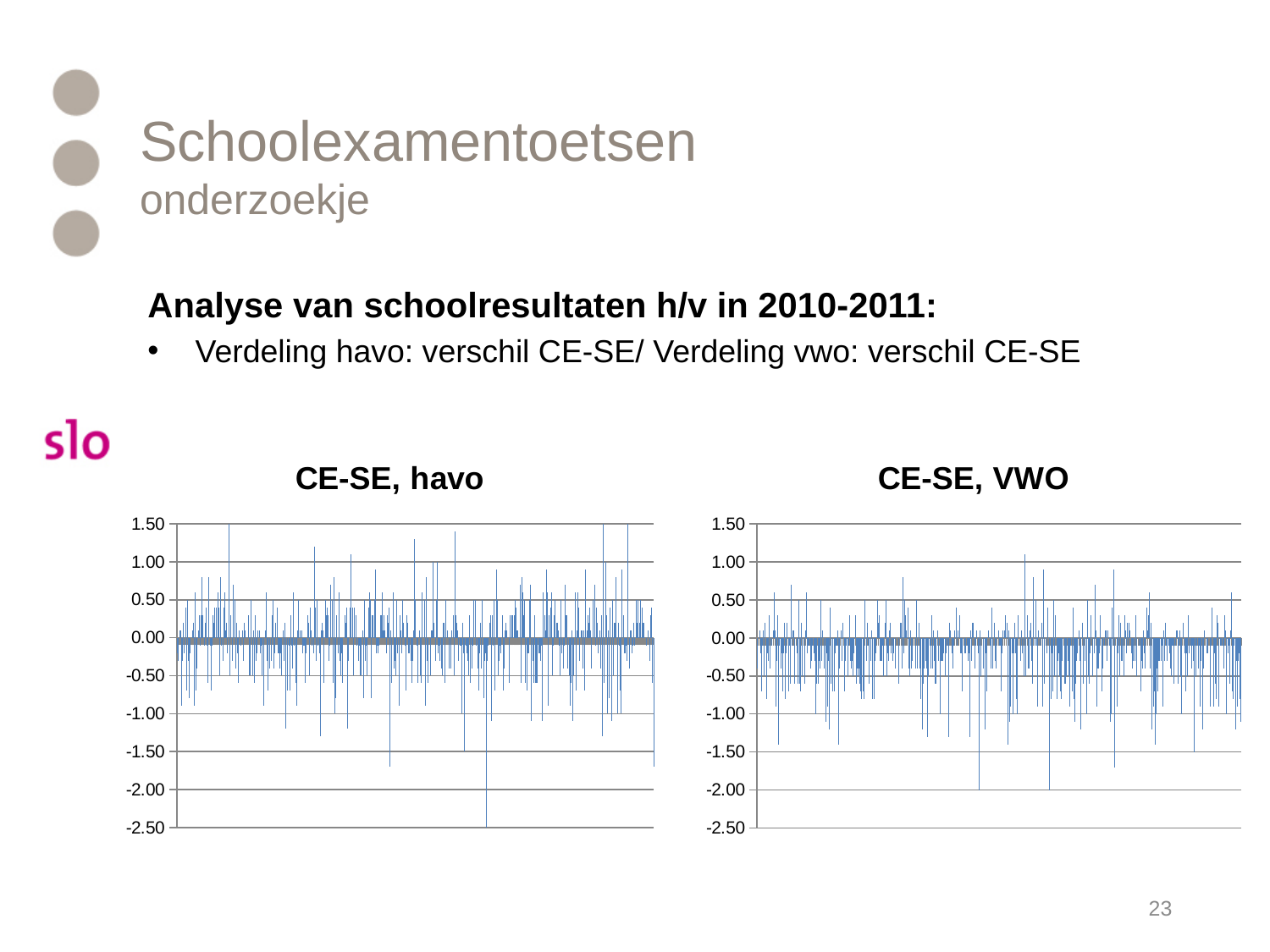
What is the title of the chart on the right of the slide? CE-SE, VWO What is the title of the chart on the left of the slide? CE-SE, havo In the "CE-SE, havo" chart, is the lowest plotted value greater or less than -2.00? less How many charts are shown on the slide? 2 In the "CE-SE, VWO" chart, is the lowest plotted value greater or less than -1.50? less In the "CE-SE, havo" chart, is the highest plotted value greater or less than 1.00? greater What kind of chart is the "CE-SE, VWO" chart? bar chart What kind of chart is the "CE-SE, havo" chart? bar chart